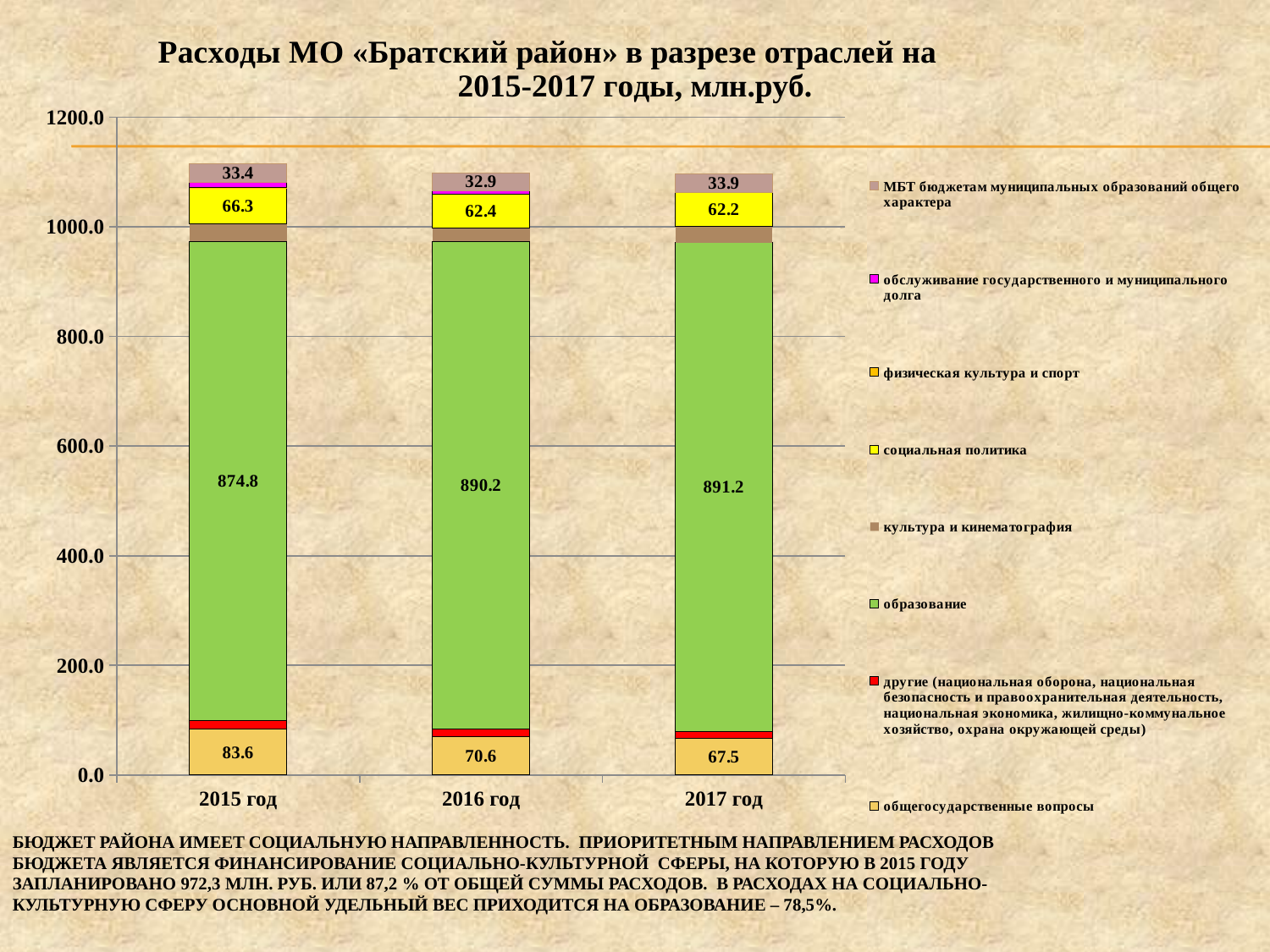
What is the value for социальная политика in 2017 год? 62.2 What type of chart is shown on the slide? stacked bar chart How many years (categories) are shown on the x axis? 3 Which is larger: социальная политика in 2015 год or in 2016 год? 2015 год What is the value for образование in 2015 год? 874.8 What is the value for МБТ бюджетам муниципальных образований общего характера in 2016 год? 32.9 Does the value for общегосударственные вопросы rise or fall from 2015 год to 2017 год? fall In which year is the value for общегосударственные вопросы the lowest? 2017 год In which year is the value for образование the highest? 2017 год What is the value for общегосударственные вопросы in 2016 год? 70.6 What is the difference between the образование values for 2016 год and 2015 год? 15.4 How many series does the legend list? 8